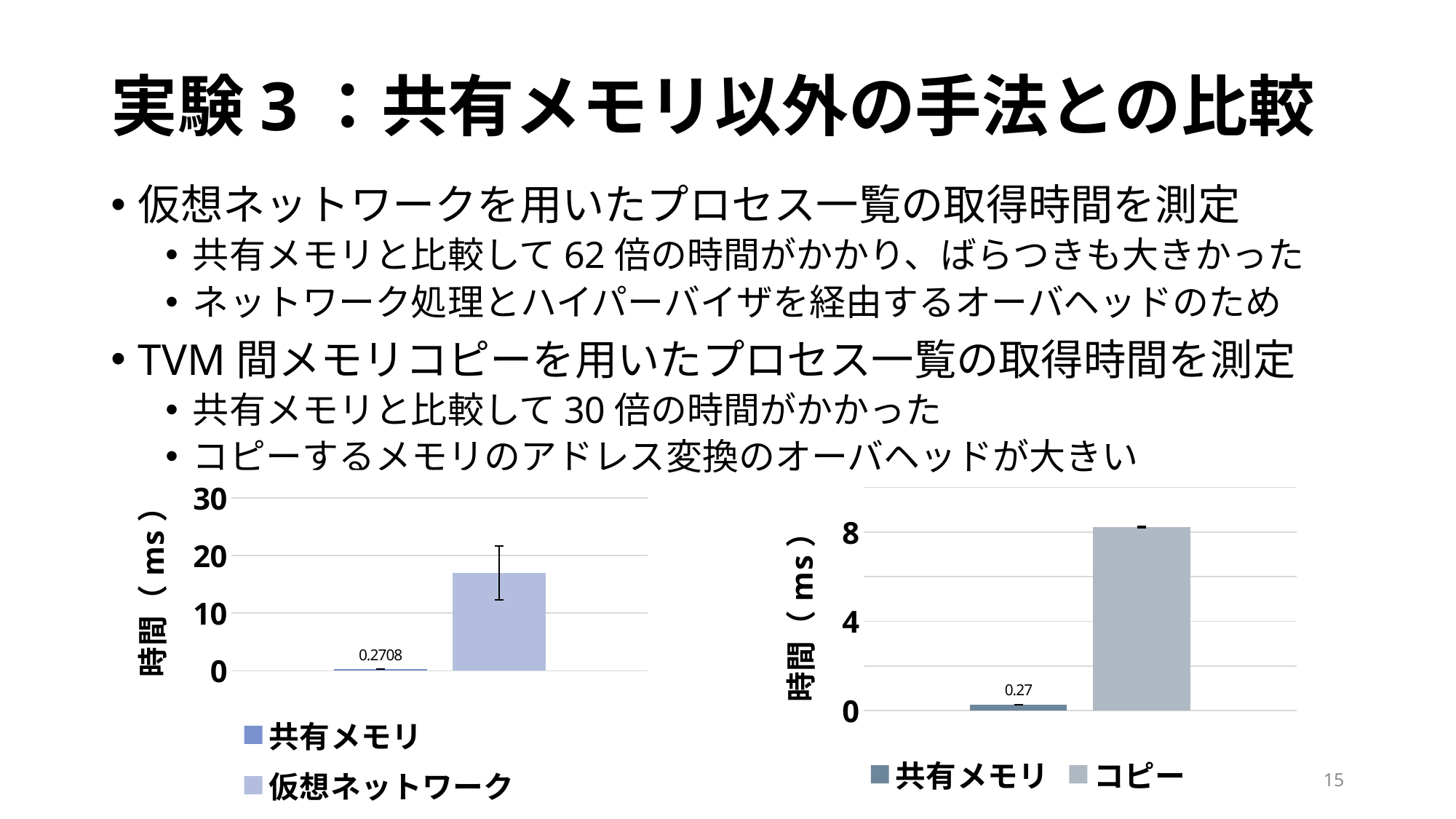
In the left chart, is the value for 仮想ネットワーク greater or less than 10? greater In the right chart, which is larger, 共有メモリ or コピー? コピー In the left chart, which series has the highest value? 仮想ネットワーク In the right chart, which series has the lowest value? 共有メモリ What is the y-axis label of the right chart? 時間（ms） In the right chart, is the value for コピー greater or less than 4? greater In the left chart, what is the value for 共有メモリ? 0.2708 How many series does the legend of the right chart list? 2 In the left chart, is the value for 仮想ネットワーク greater or less than 20? less How many series does the legend of the left chart list? 2 In the right chart, what is the value for 共有メモリ? 0.27 What kind of chart is the left chart? bar chart